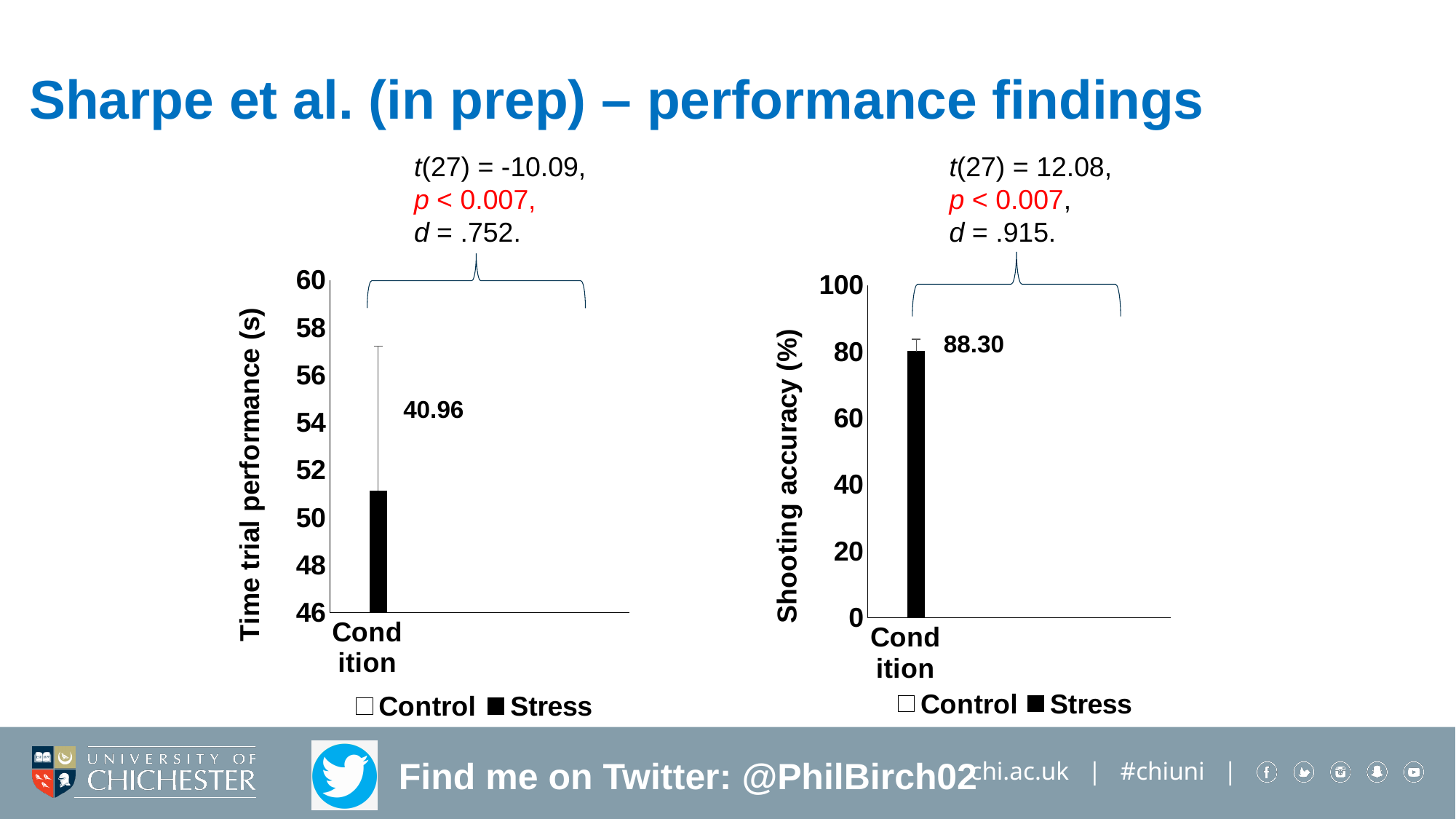
In the left chart (Time trial performance), how many series does the legend list? 2 In the left chart, what is the y-axis title? Time trial performance (s) What kind of chart is the right chart (Shooting accuracy)? bar chart In the right chart, how many categories are shown on the x axis? 1 In the right chart (Shooting accuracy), is the value of the black Stress bar greater or less than 60? greater In the right chart (Shooting accuracy), what are the two series named in the legend? Control and Stress What data label value is printed on the right chart (Shooting accuracy)? 88.30 In the left chart (Time trial performance), is the value of the black Stress bar greater or less than 48? greater In the right chart (Shooting accuracy), what is the highest value shown on the y axis? 100 In the left chart (Time trial performance), is the value of the black Stress bar greater or less than 54? less What kind of chart is the left chart (Time trial performance)? bar chart What data label value is printed on the left chart (Time trial performance)? 40.96